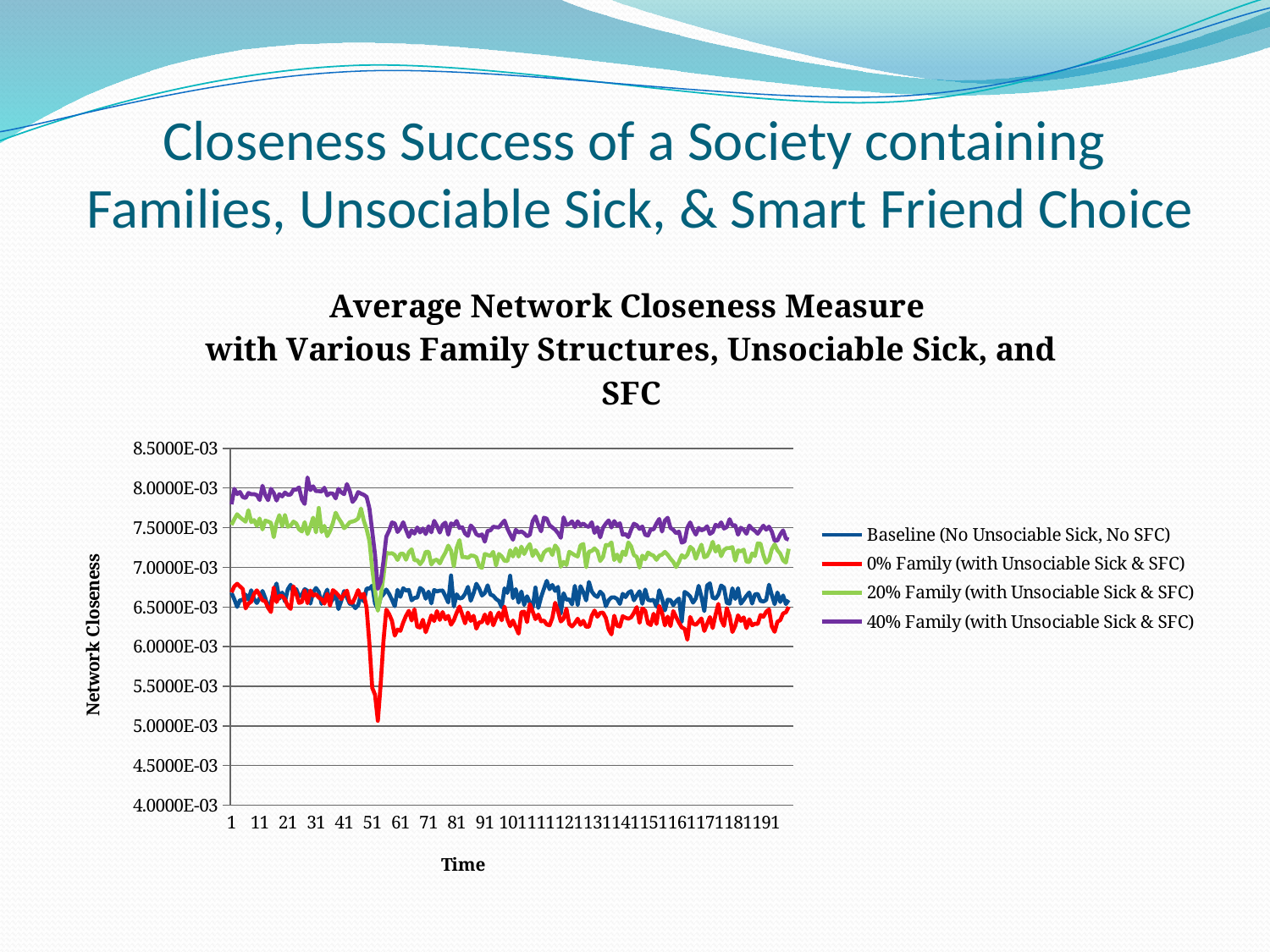
At time 101, which is larger: the value for 40% Family (with Unsociable Sick & SFC) or the value for 20% Family (with Unsociable Sick & SFC)? 40% Family (with Unsociable Sick & SFC) Does the 40% Family (with Unsociable Sick & SFC) line rise or fall from time 1 to time 191? fall Is the value for 0% Family (with Unsociable Sick & SFC) at time 101 greater or less than 6.5000E-03? less How many series does the legend list? 4 Is the value for Baseline (No Unsociable Sick, No SFC) at time 151 greater or less than 7.0000E-03? less Which series has the lowest values after time 61? 0% Family (with Unsociable Sick & SFC) What is the title of the chart? Average Network Closeness Measure with Various Family Structures, Unsociable Sick, and SFC Is the lowest point of the 0% Family (with Unsociable Sick & SFC) line greater or less than 5.5000E-03? less Which series has the highest values across the chart? 40% Family (with Unsociable Sick & SFC) What kind of chart is shown on the slide? line chart What is the label of the vertical axis? Network Closeness